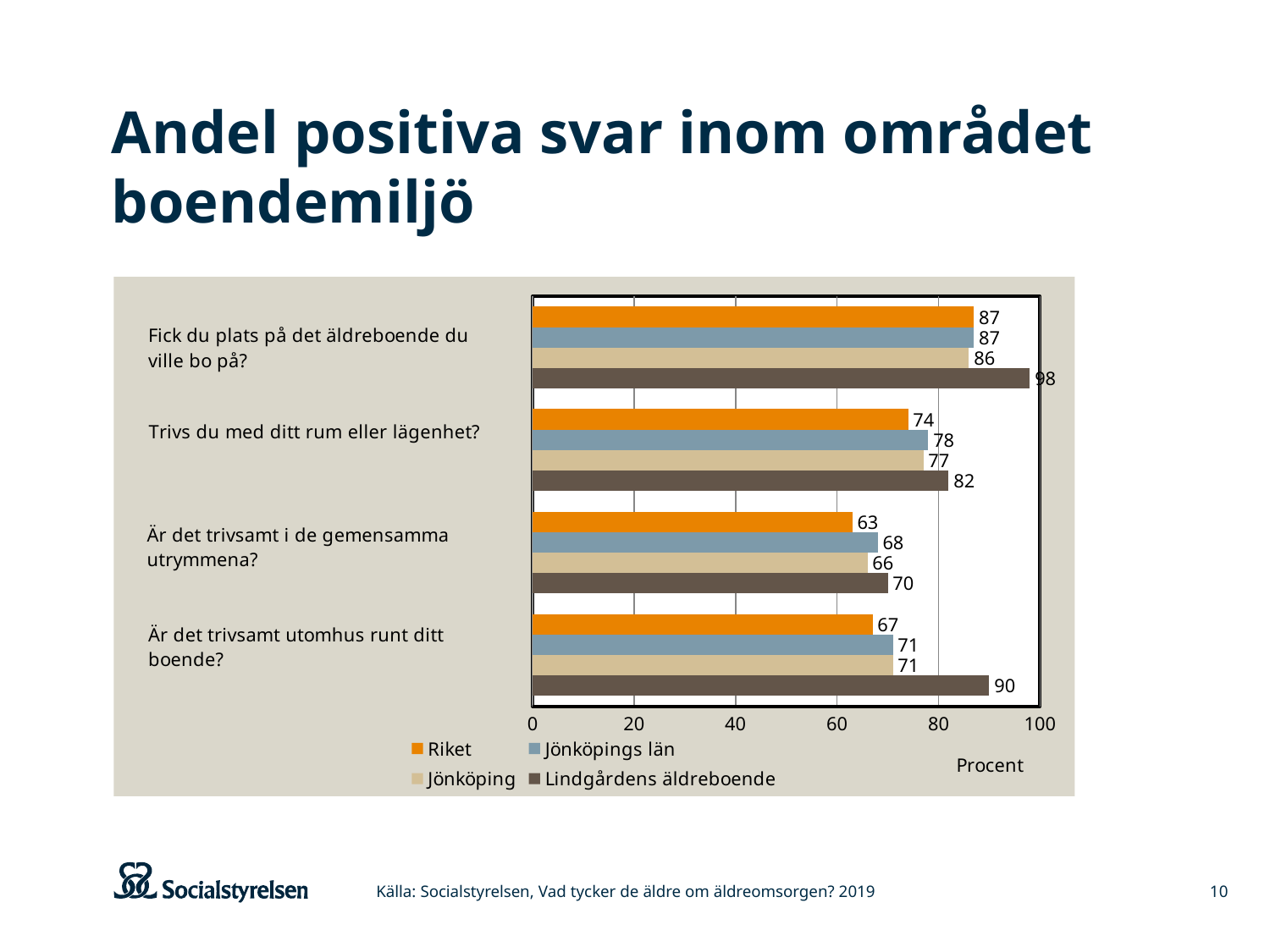
What is the difference between Lindgårdens äldreboende and Riket on "Är det trivsamt utomhus runt ditt boende?"? 23 Which series has the lowest value on "Är det trivsamt i de gemensamma utrymmena?"? Riket How many question categories are shown on the chart? 4 Which series has the highest value on "Är det trivsamt utomhus runt ditt boende?"? Lindgårdens äldreboende What is the label on the horizontal axis of the chart? Procent Which is larger on "Trivs du med ditt rum eller lägenhet?": Jönköpings län or Riket? Jönköpings län How many series does the legend list? 4 What is the value for Riket on "Trivs du med ditt rum eller lägenhet?"? 74 What kind of chart is shown on the slide? Bar chart What is the value for Lindgårdens äldreboende on "Fick du plats på det äldreboende du ville bo på?"? 98 What is the value for Jönköping on "Är det trivsamt utomhus runt ditt boende?"? 71 What is the value for Jönköpings län on "Är det trivsamt i de gemensamma utrymmena?"? 68